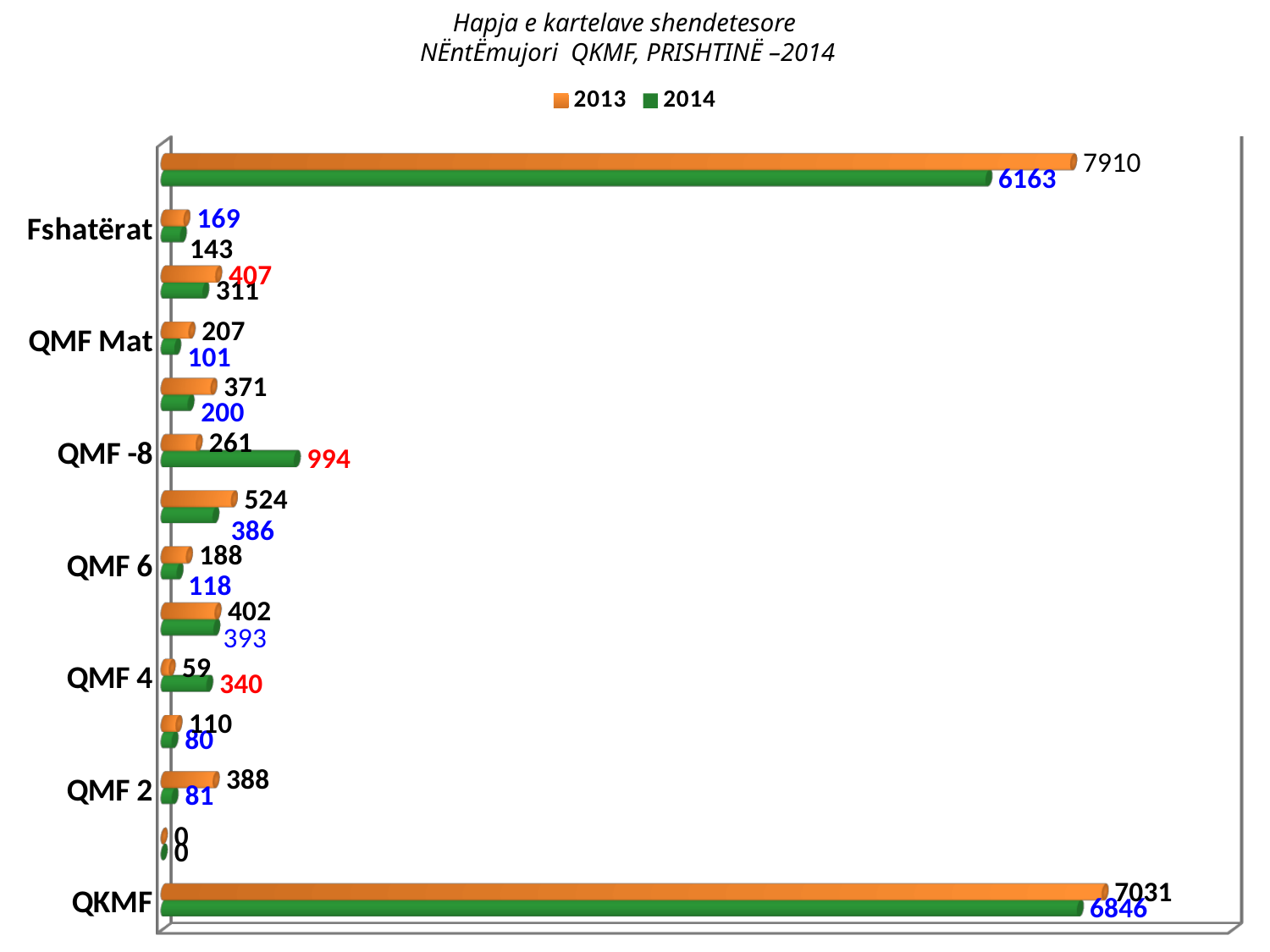
What is the 2013 value for QMF 4? 59 What is the 2013 value for QMF 2? 388 For QMF 2, which series has the larger value, 2013 or 2014? 2013 What kind of chart is shown on the slide? Bar chart For QMF 4, which series has the larger value, 2013 or 2014? 2014 What is the difference between the 2014 and 2013 values for QMF -8? 733 What is the 2014 value for QKMF? 6846 What is the 2014 value for QMF Mat? 101 What is the 2014 value for QMF -8? 994 What is the 2013 value for QKMF? 7031 What is the difference between the 2013 and 2014 values for QKMF? 185 How many series does the legend list? 2